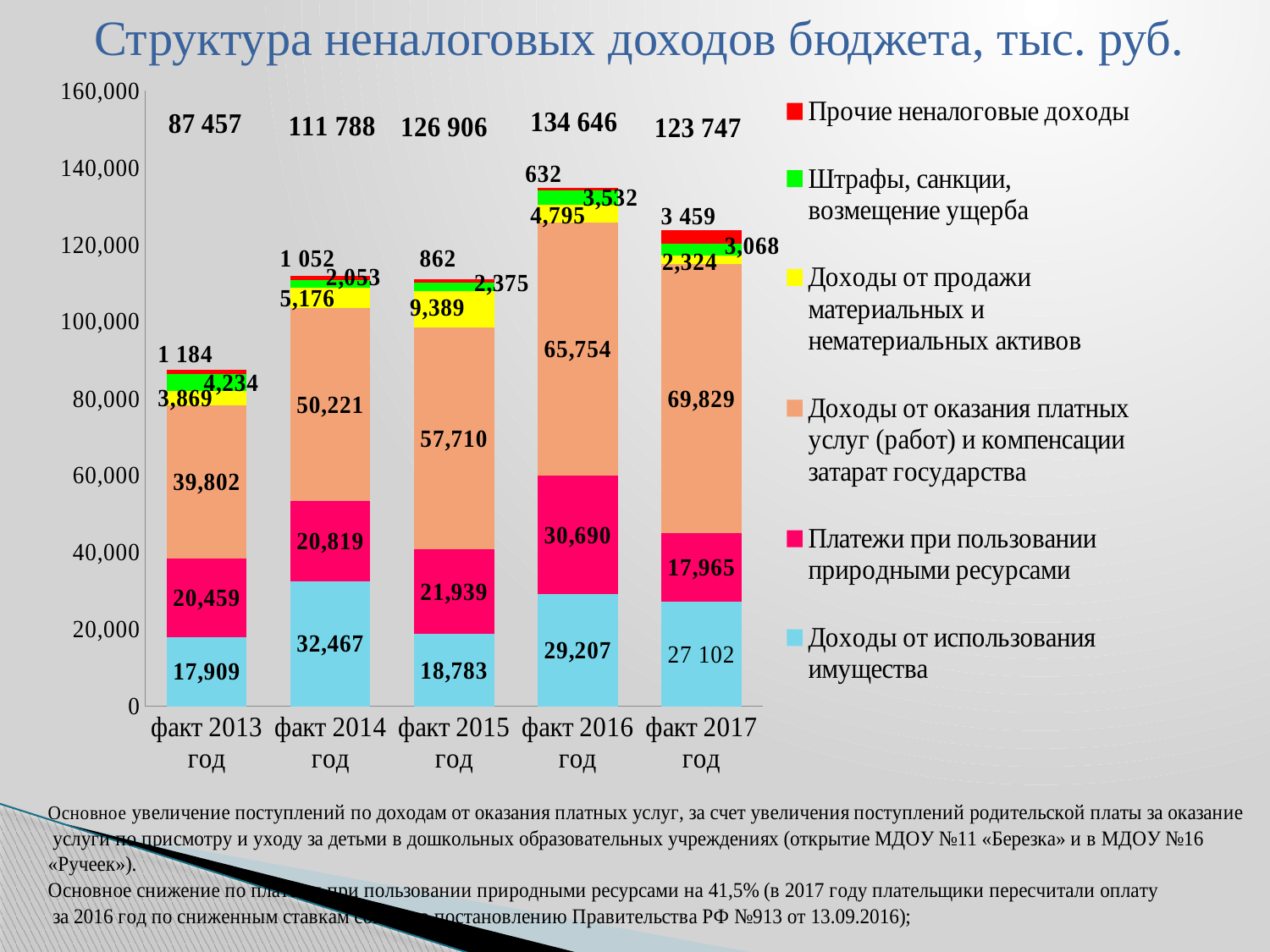
What is the value of Платежи при пользовании природными ресурсами for факт 2016 год? 30,690 What is the difference in Доходы от оказания платных услуг (работ) и компенсации затарат государства between факт 2017 год and факт 2016 год? 4,075 How many series does the legend list? 6 What is the total of the stacked bar for факт 2015 год? 126 906 What is the value of Доходы от использования имущества for факт 2014 год? 32,467 Does the value of Доходы от оказания платных услуг (работ) и компенсации затарат государства rise or fall from факт 2013 год to факт 2017 год? rise Which is larger for Платежи при пользовании природными ресурсами: факт 2014 год or факт 2017 год? факт 2014 год What kind of chart is shown on the slide? stacked bar chart Which year has the lowest total non-tax revenue? факт 2013 год What is the value of Прочие неналоговые доходы for факт 2017 год? 3 459 How many years (categories) are shown on the x axis? 5 Which year has the highest total non-tax revenue? факт 2016 год